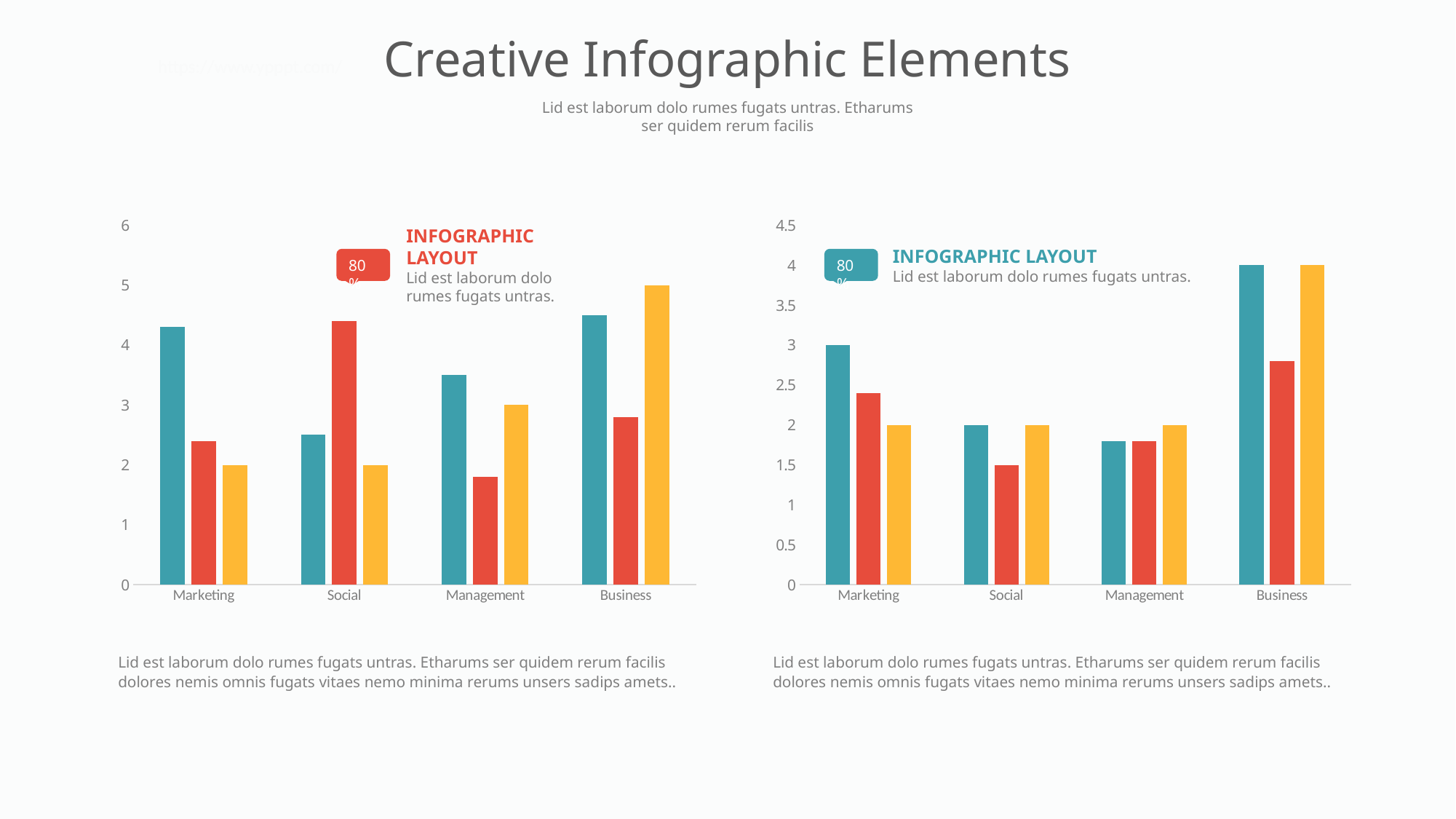
In the left chart, which category has the tallest yellow bar? Business In the left chart, which is larger for Social: the teal bar or the red bar? the red bar In the left chart, is the teal bar for Marketing greater or less than 4? greater In the left chart, what is the value of the yellow bar for Business? 5 In the left chart, what is the value of the yellow bar for Management? 3 How many categories are shown on the x axis of the right chart? 4 In the right chart, what is the value of the teal bar for Business? 4 In the right chart, what is the value of the red bar for Social? 1.5 In the left chart, how many bars are plotted for each category? 3 In the right chart, which category has the lowest red bar? Social In the right chart, is the red bar for Business greater or less than 2.5? greater What kind of chart is the left chart? bar chart